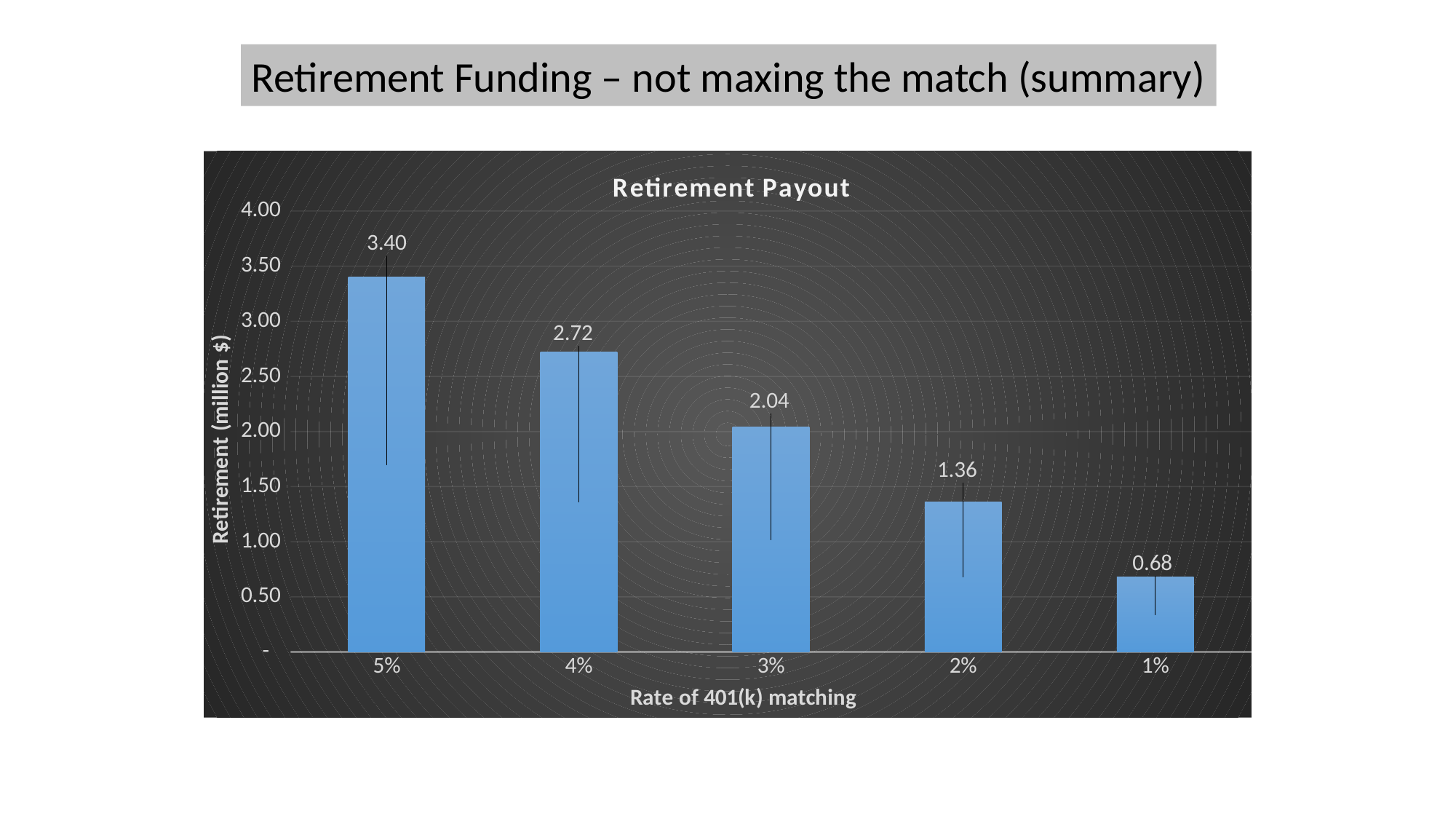
What is the retirement payout for a 5% rate of 401(k) matching? 3.40 What is the retirement payout for a 1% rate of 401(k) matching? 0.68 Which has a larger retirement payout, the 3% or the 2% matching rate? 3% What is the title of the chart? Retirement Payout Which rate of 401(k) matching has the highest retirement payout? 5% What is the retirement payout for a 3% rate of 401(k) matching? 2.04 Which rate of 401(k) matching has the lowest retirement payout? 1% How many rates of 401(k) matching are shown on the chart? 5 Do the retirement payout values rise or fall moving from left to right along the x axis? fall What is the difference in retirement payout between the 4% and 2% matching rates? 1.36 Is the retirement payout for the 4% matching rate greater or less than 2.50? greater What kind of chart is shown on the slide? bar chart